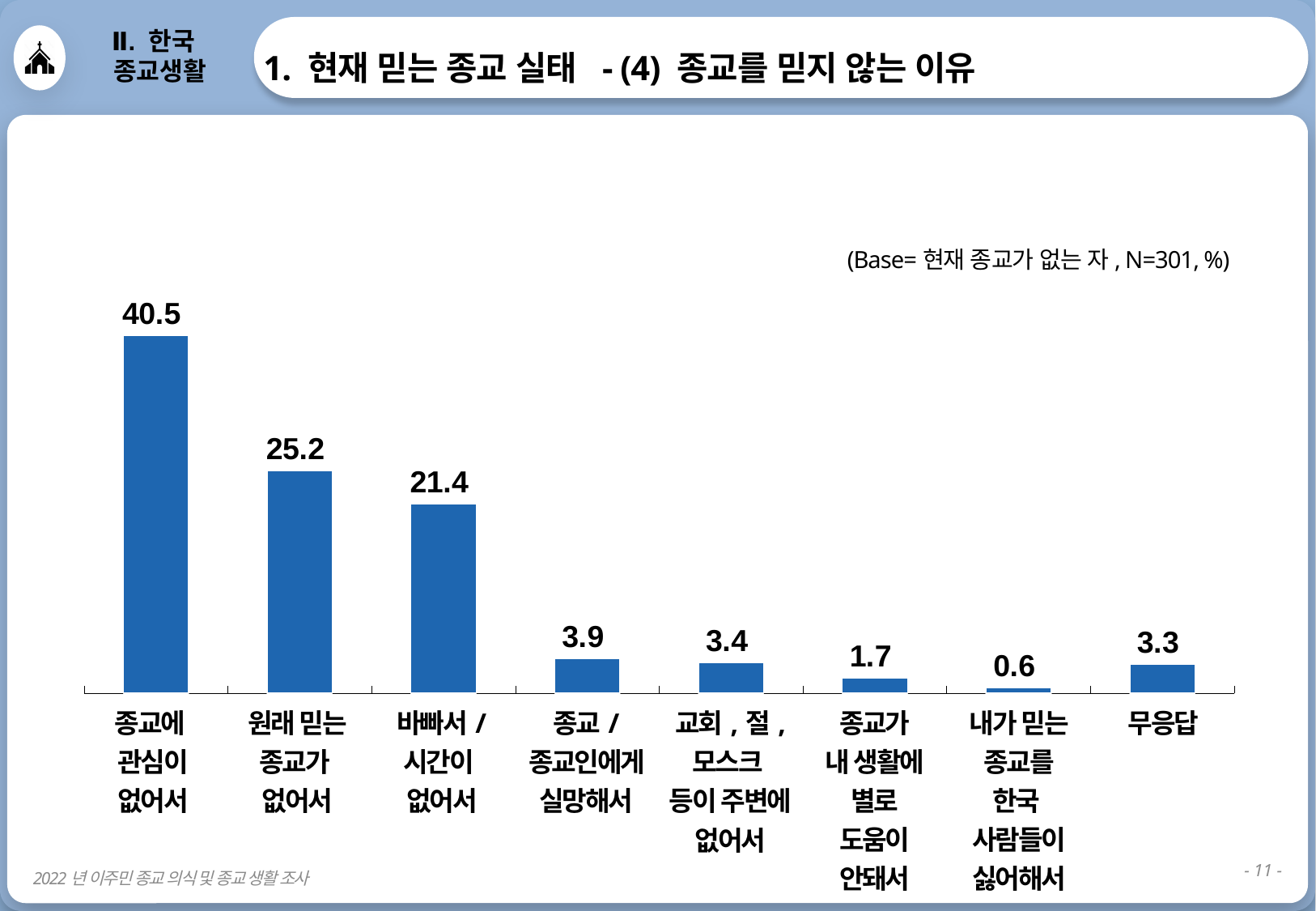
What is the value for '무응답'? 3.3 What is the difference between '종교에 관심이 없어서' and '원래 믿는 종교가 없어서'? 15.3 What is the value for '바빠서 / 시간이 없어서'? 21.4 What is the value for '종교에 관심이 없어서'? 40.5 What kind of chart is shown on the slide? Bar chart What is the sample size (N) stated in the base note on the chart? 301 Which category has the highest value? 종교에 관심이 없어서 Which is larger, '종교 / 종교인에게 실망해서' or '무응답'? 종교 / 종교인에게 실망해서 What is the difference between '원래 믿는 종교가 없어서' and '바빠서 / 시간이 없어서'? 3.8 Which category has the lowest value? 내가 믿는 종교를 한국 사람들이 싫어해서 How many categories are shown in the chart? 8 What is the value for '종교가 내 생활에 별로 도움이 안돼서'? 1.7